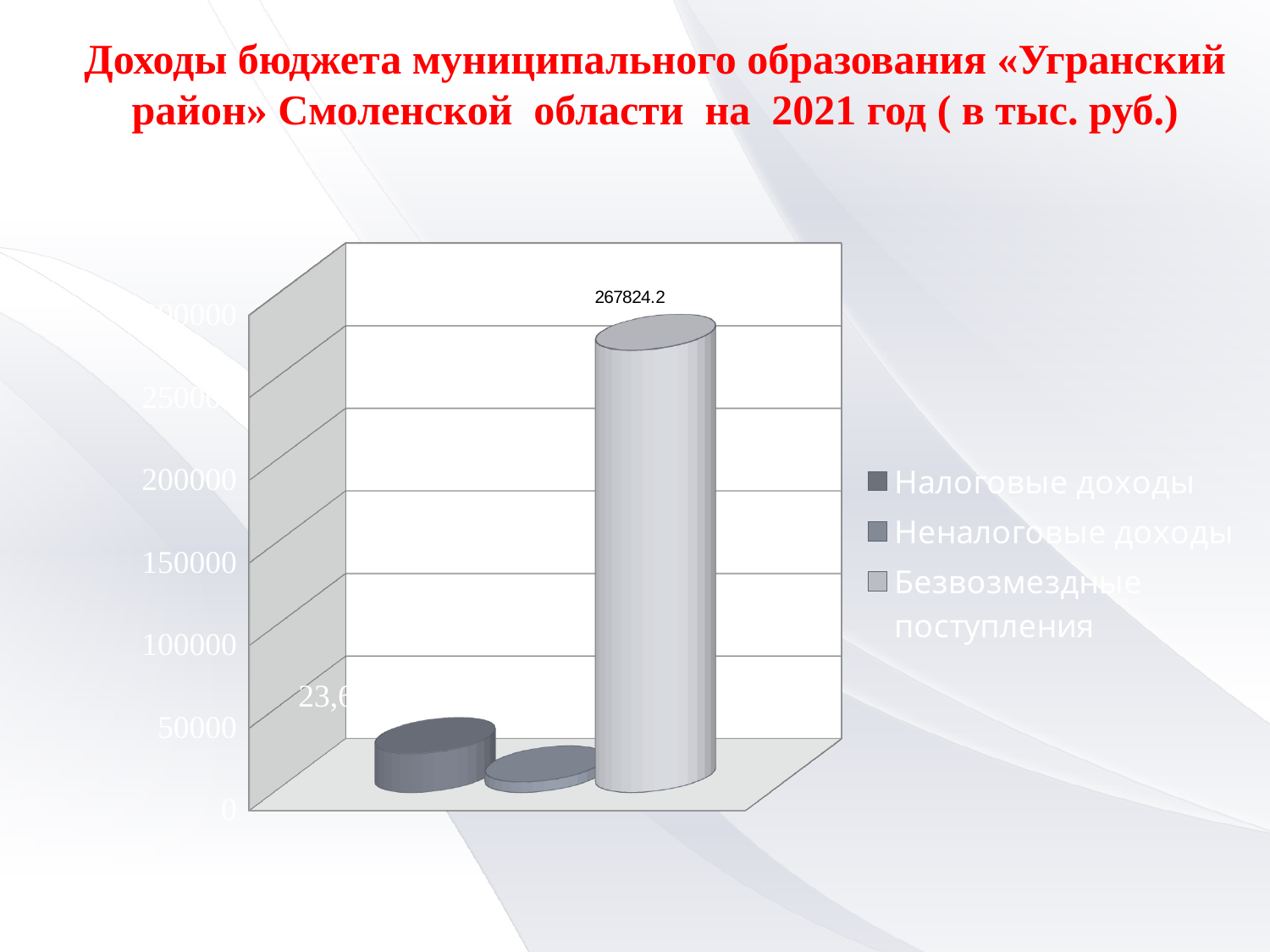
Is the value for Налоговые доходы greater or less than 50000? less Which series has the lowest value? Неналоговые доходы How many bars are plotted on the chart? 3 What is the value shown for Безвозмездные поступления? 267824.2 What kind of chart is shown on the slide? bar chart Which is larger, Налоговые доходы or Неналоговые доходы? Налоговые доходы Which is larger, Безвозмездные поступления or Налоговые доходы? Безвозмездные поступления How many series does the legend list? 3 Is the value for Безвозмездные поступления greater or less than 250000? greater Is the value for Неналоговые доходы greater or less than 50000? less In what units are the values on the chart given, according to the slide title? тыс. руб. Which series has the highest value? Безвозмездные поступления